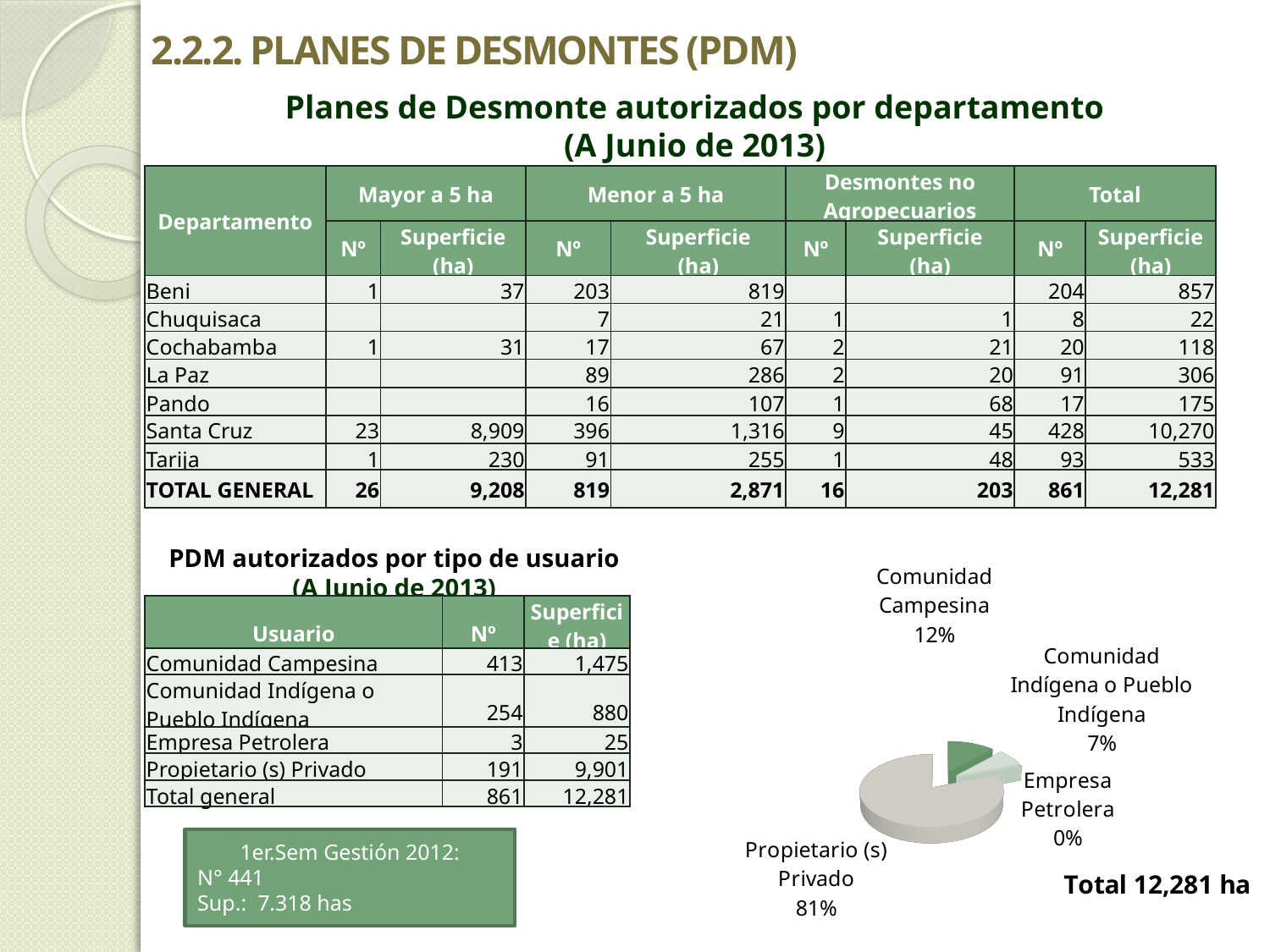
In the pie chart, what is the combined share of Comunidad Campesina and Comunidad Indígena o Pueblo Indígena? 19% In the pie chart, what share does Empresa Petrolera have? 0% How many slices does the pie chart have? 4 In the pie chart, what share does Comunidad Indígena o Pueblo Indígena have? 7% Which slice of the pie chart is the smallest? Empresa Petrolera In the pie chart, what share does Comunidad Campesina have? 12% In the pie chart, what is the difference in percentage points between Propietario (s) Privado and Comunidad Campesina? 69 In the pie chart, which is larger: Comunidad Campesina or Comunidad Indígena o Pueblo Indígena? Comunidad Campesina Which slice of the pie chart is the largest? Propietario (s) Privado What total area in hectares is stated next to the pie chart? Total 12,281 ha What kind of chart is shown on the slide? pie chart